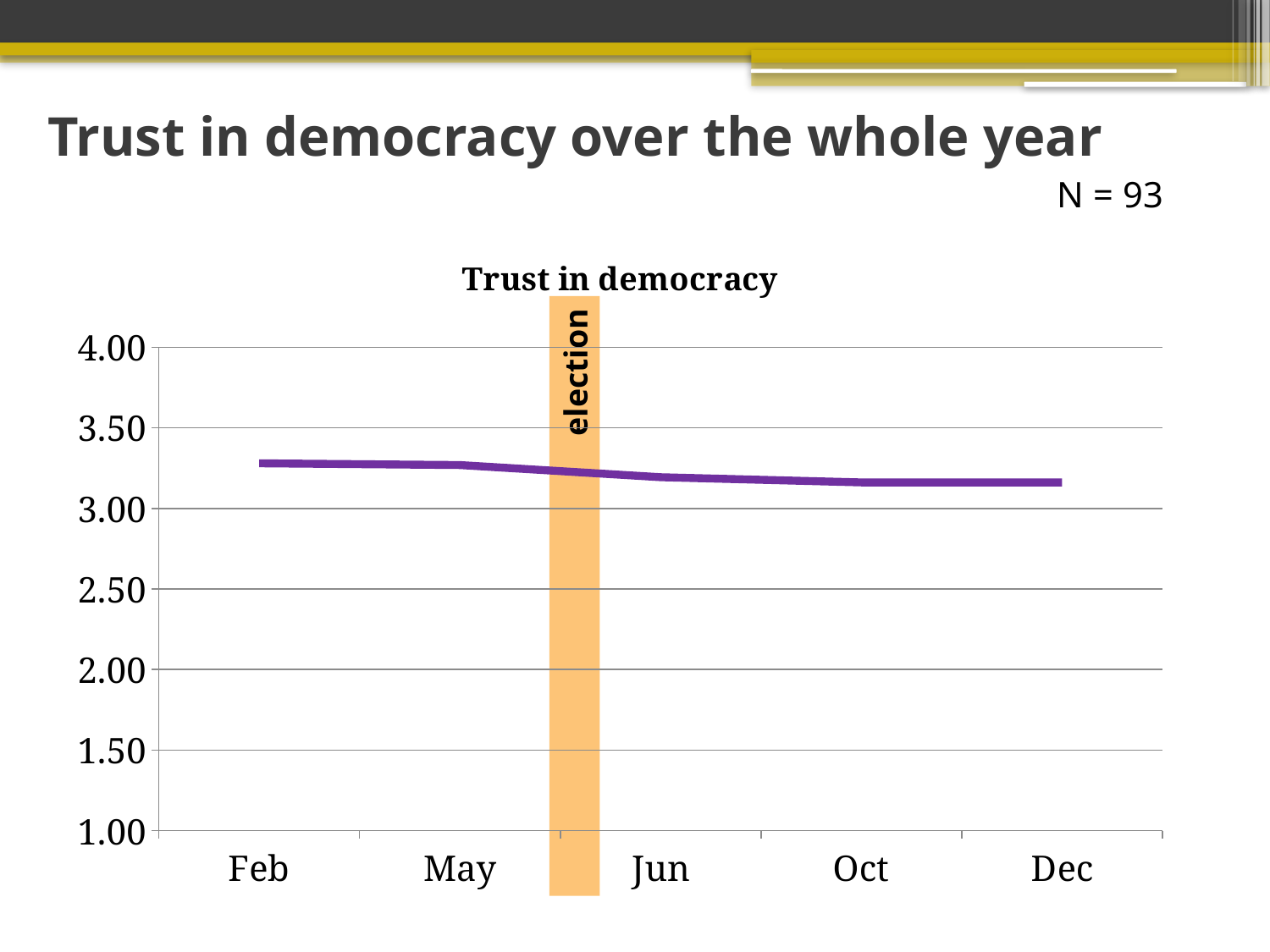
What kind of chart is shown on the slide? line chart Do the values rise or fall from Feb to Dec? fall Is the value for Dec greater or less than 3.00? greater How many months are labelled on the x axis of the chart? 5 Is the value for Oct greater or less than 3.50? less What event does the orange vertical band on the chart mark? election What is the lowest value shown on the y axis of the chart? 1.00 Is the value for Feb greater or less than 3.00? greater What is the title of the chart? Trust in democracy Which is larger, the value for Feb or the value for Dec? Feb